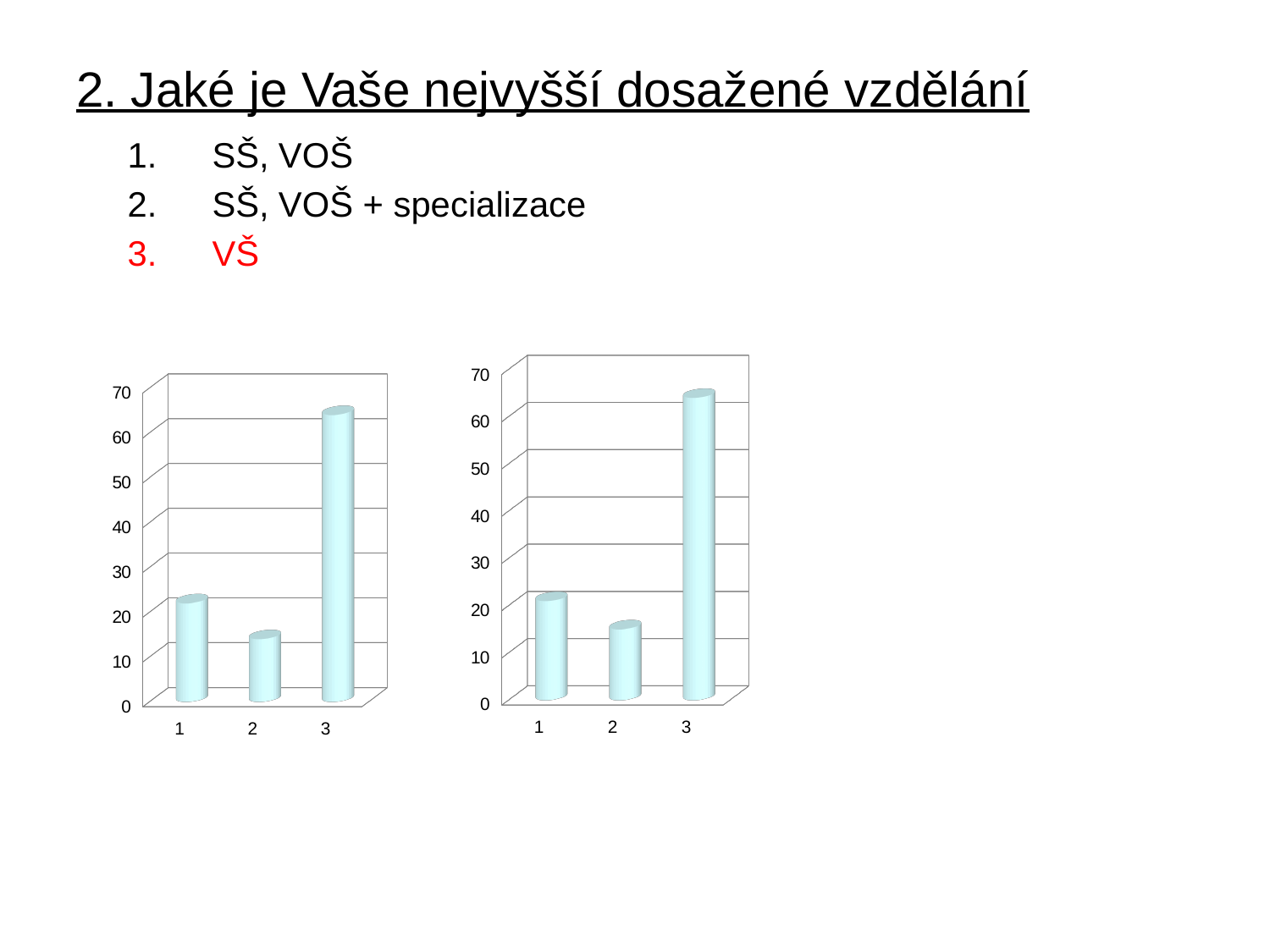
In the right chart, is the value for category 2 greater or less than 10? greater In the left chart, is the value for category 2 greater or less than 20? less In the right chart, which is larger, the value for category 1 or the value for category 2? category 1 In the left chart, which category has the highest bar? 3 In the left chart, is the value for category 3 greater or less than 60? greater In the left chart, which category has the lowest bar? 2 What kind of chart is the left chart on the slide? bar chart In the right chart, which category has the highest bar? 3 In the right chart, which category has the lowest bar? 2 How many categories are shown on the x axis of the left chart? 3